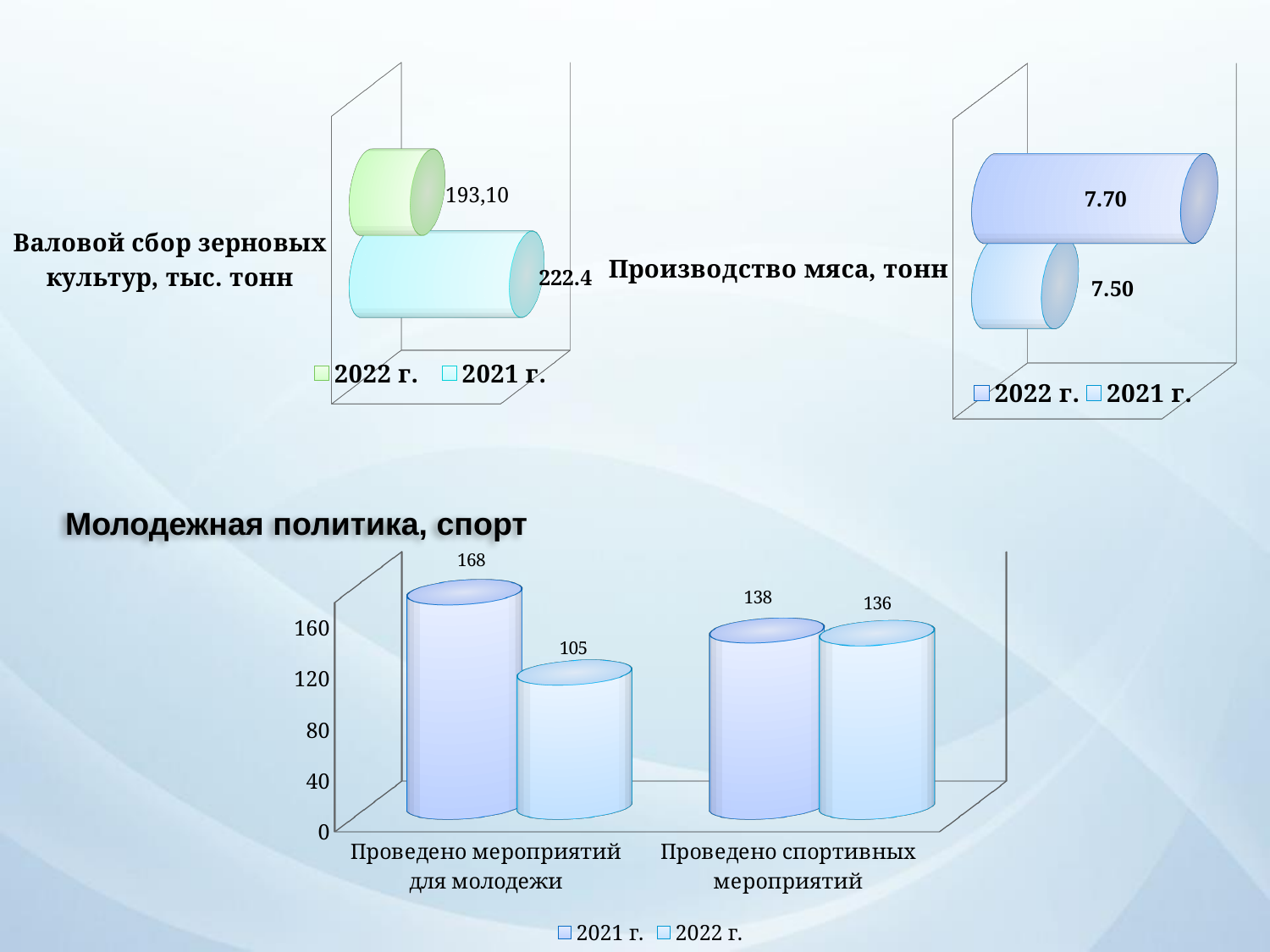
In the 'Молодежная политика, спорт' chart, what is the value for 2022 г. in 'Проведено спортивных мероприятий'? 136 In the 'Производство мяса, тонн' chart, what is the value for 2022 г.? 7.70 In the 'Молодежная политика, спорт' chart, which bar is the lowest? 2022 г. in 'Проведено мероприятий для молодежи' (105) In the 'Производство мяса, тонн' chart, what is the value for 2021 г.? 7.50 In the 'Производство мяса, тонн' chart, how many series does the legend list? 2 In the 'Валовой сбор зерновых культур, тыс. тонн' chart, what is the value for 2022 г.? 193,10 In the 'Молодежная политика, спорт' chart, what is the difference between the 2021 г. and 2022 г. values for 'Проведено мероприятий для молодежи'? 63 In the 'Молодежная политика, спорт' chart, what is the value for 2021 г. in 'Проведено мероприятий для молодежи'? 168 In the 'Валовой сбор зерновых культур, тыс. тонн' chart, which year has the larger value, 2022 г. or 2021 г.? 2021 г. In the 'Валовой сбор зерновых культур, тыс. тонн' chart, what is the value for 2021 г.? 222.4 In the 'Молодежная политика, спорт' chart, how many categories are shown on the x axis? 2 What kind of chart is the 'Молодежная политика, спорт' chart? Bar chart